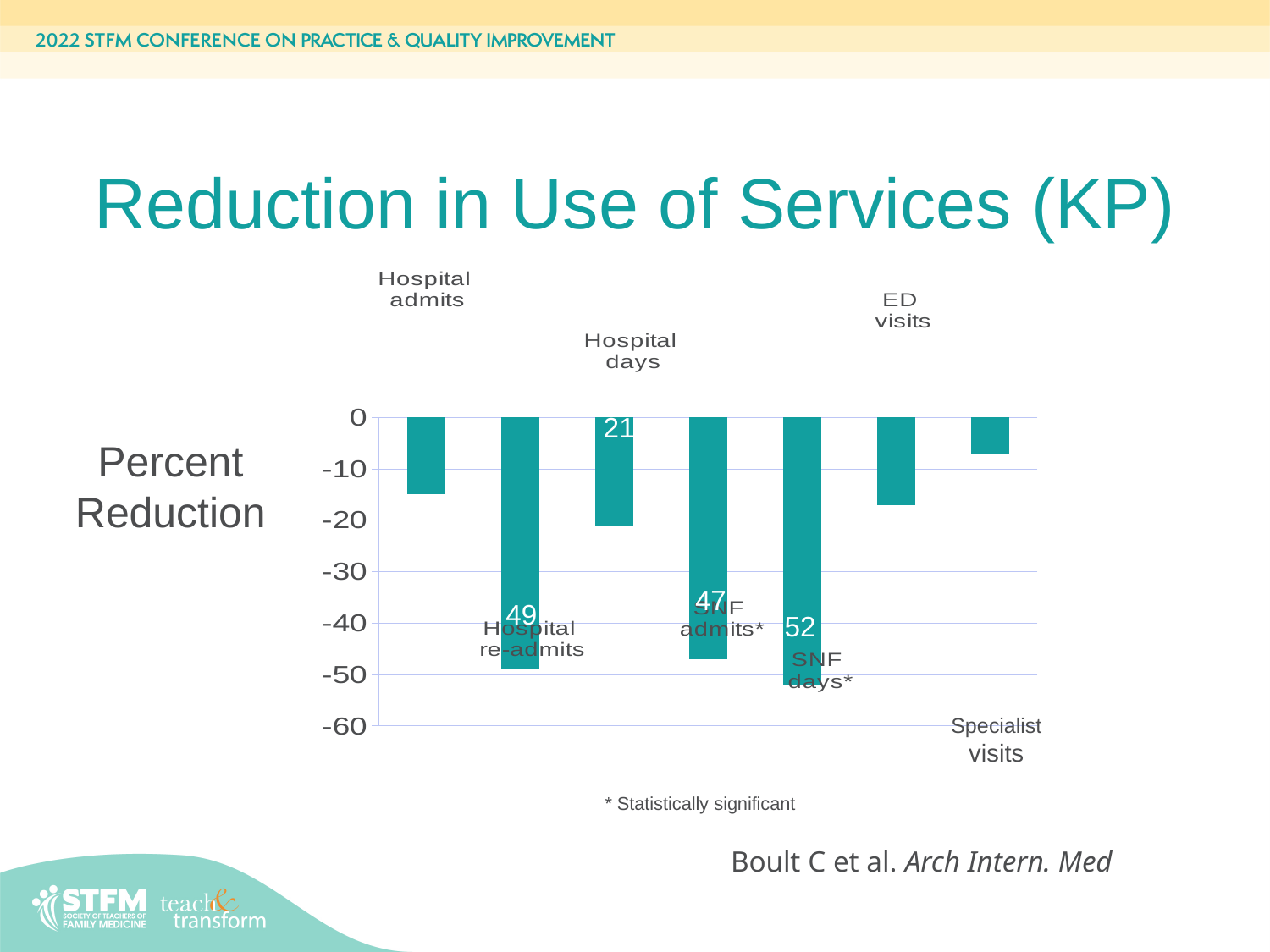
What type of chart is shown on the slide? Bar chart Is the value for Specialist visits greater or less than -10? greater Which category shows the largest percent reduction? SNF days* What is the data label on the SNF days* bar? 52 What is the data label on the Hospital days bar? 21 What is the data label on the Hospital re-admits bar? 49 Which category shows the smallest percent reduction? Specialist visits What is the data label on the SNF admits* bar? 47 Is the value for Hospital admits greater or less than -10? less How many categories are plotted in the chart? 7 What is the difference between the labelled values for SNF days* and Hospital days? 31 Which has the larger labelled reduction, Hospital re-admits or SNF admits*? Hospital re-admits